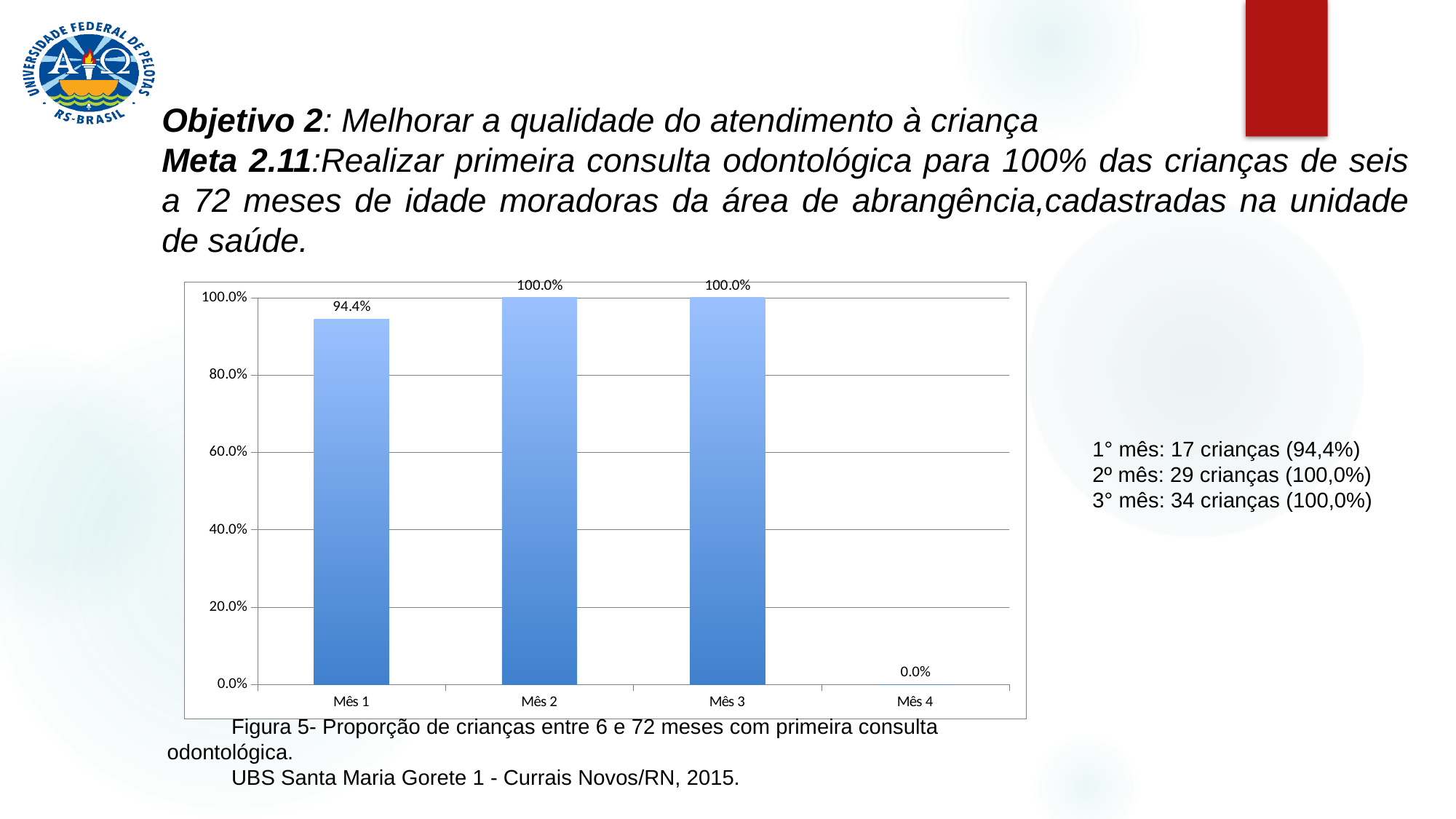
Which category has the lowest value? Mês 4 What is the value for Mês 1? 94.4% How many categories are shown on the x axis? 4 What is the difference between the values for Mês 2 and Mês 1? 5.6% What is the figure number given in the caption below the chart? Figura 5 Which is larger, the value for Mês 1 or the value for Mês 3? Mês 3 Is the value for Mês 1 greater or less than 80.0%? greater What is the highest value shown on the y axis? 100.0% What is the value for Mês 4? 0.0% What kind of chart is shown on the slide? bar chart What is the value for Mês 2? 100.0% Do the values rise or fall from Mês 1 to Mês 2? rise